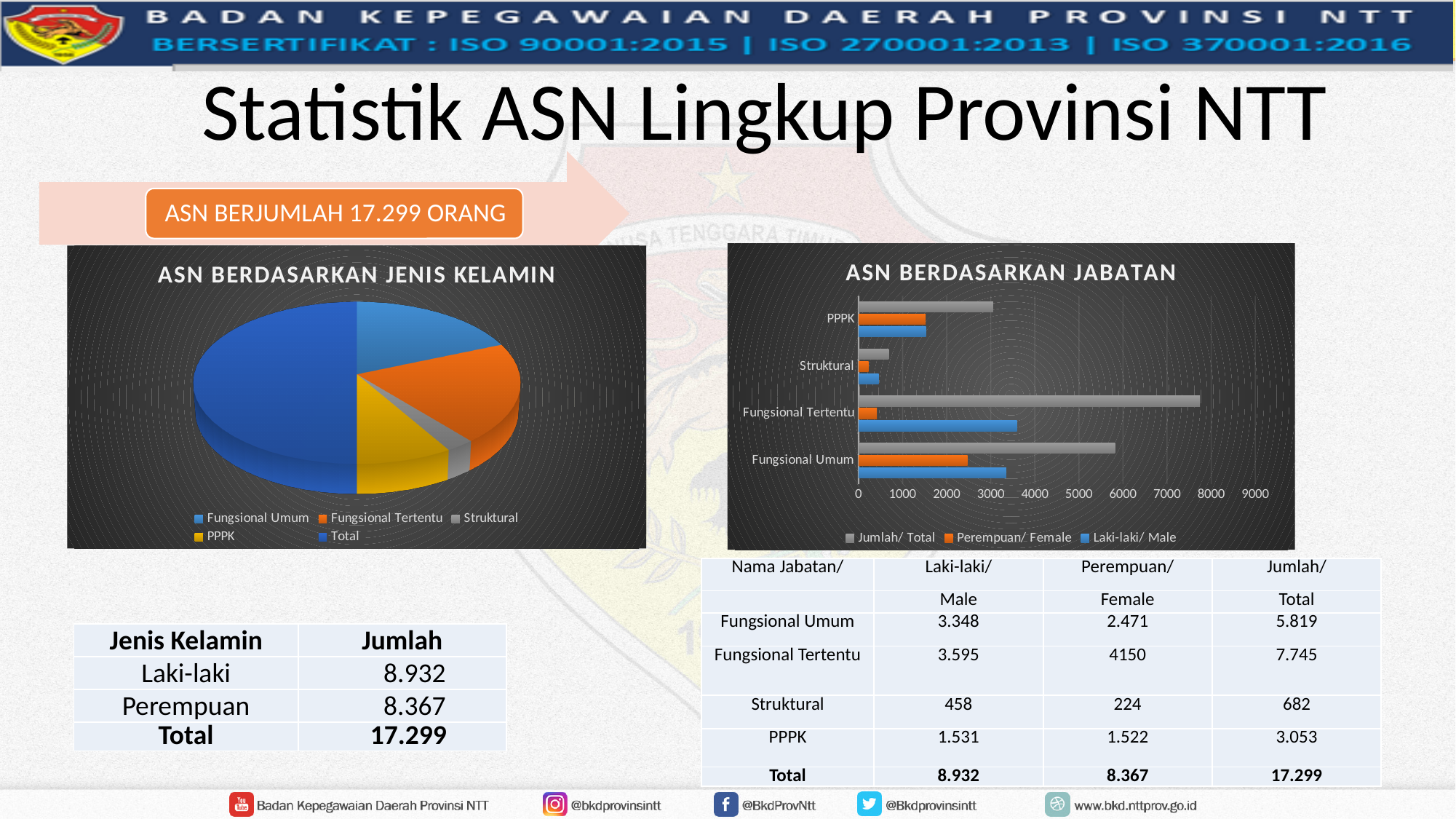
In the 'ASN BERDASARKAN JABATAN' chart, which category has the highest Jumlah/ Total value? Fungsional Tertentu In the 'ASN BERDASARKAN JABATAN' chart, for Fungsional Umum, which is larger: the Laki-laki/ Male bar or the Perempuan/ Female bar? Laki-laki/ Male In the 'ASN BERDASARKAN JABATAN' chart, is the Jumlah/ Total value for Fungsional Tertentu greater or less than 7000? greater In the 'ASN BERDASARKAN JABATAN' chart, is the Laki-laki/ Male value for Fungsional Tertentu greater or less than 3000? greater What kind of chart is the 'ASN BERDASARKAN JENIS KELAMIN' chart? pie chart In the 'ASN BERDASARKAN JABATAN' chart, how many series does the legend list? 3 In the 'ASN BERDASARKAN JABATAN' chart, is the Perempuan/ Female value for Fungsional Umum greater or less than 3000? less In the 'ASN BERDASARKAN JABATAN' chart, how many job categories are shown on the vertical axis? 4 In the 'ASN BERDASARKAN JENIS KELAMIN' pie chart, how many entries does the legend list? 5 What kind of chart is the 'ASN BERDASARKAN JABATAN' chart? bar chart In the 'ASN BERDASARKAN JABATAN' chart, which category has the lowest Jumlah/ Total value? Struktural